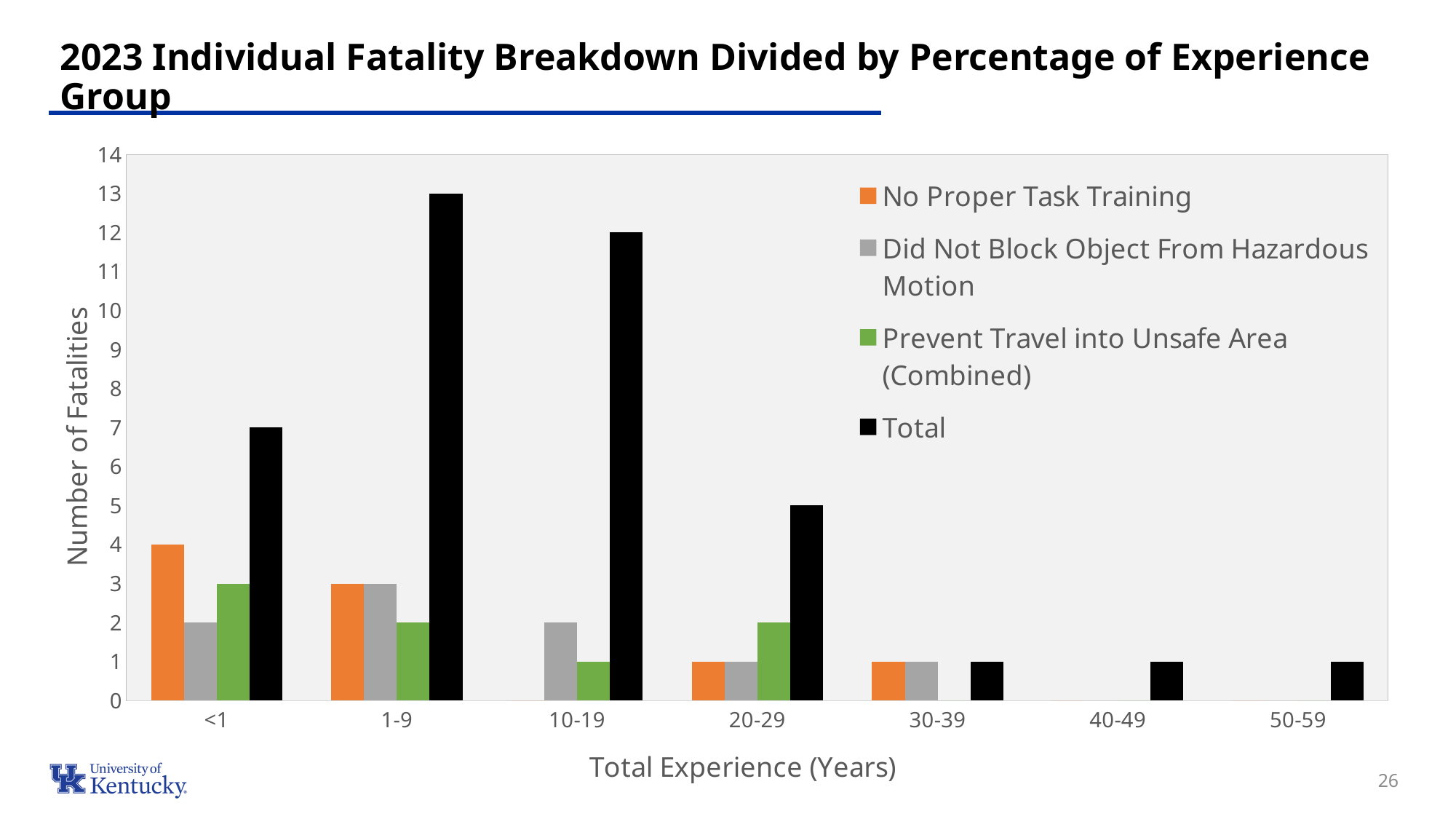
How many series does the legend list? 4 What is the value for No Proper Task Training in the <1 years experience group? 4 What is the Total number of fatalities for the 1-9 years experience group? 13 Which experience group has the highest Total number of fatalities? 1-9 Is the Total for the 10-19 years group greater or less than 10? greater What is the label of the y axis? Number of Fatalities How many experience-group categories are shown on the x axis? 7 Which is larger: the Total for the <1 group or the Total for the 20-29 group? <1 What is the Total number of fatalities for the 10-19 years experience group? 12 What type of chart is shown on the slide? bar chart What is the value for Prevent Travel into Unsafe Area (Combined) in the 20-29 years group? 2 What is the difference between the Total for the 1-9 group and the Total for the 20-29 group? 8